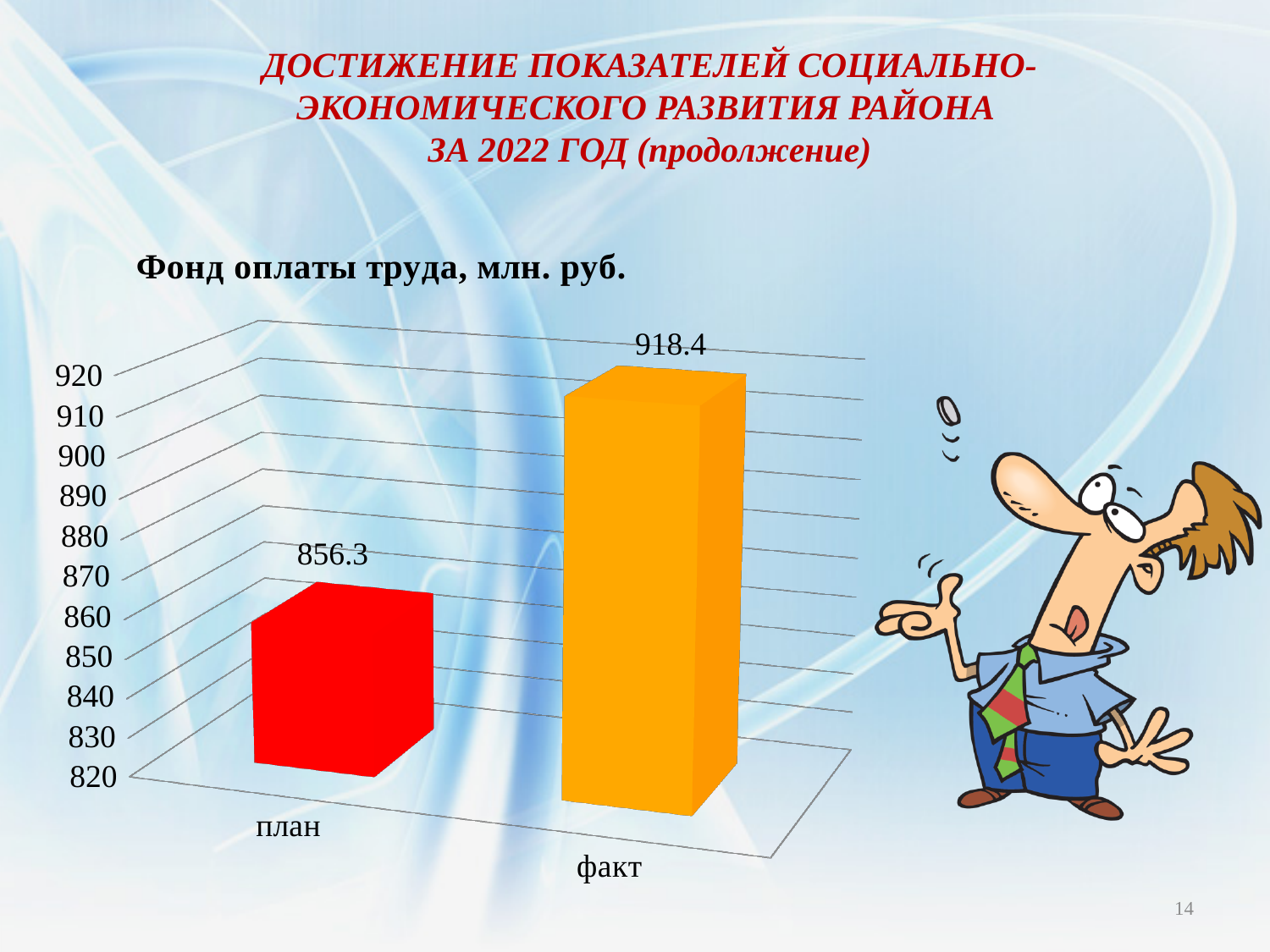
Is the value for факт greater or less than 900? greater Which category has the highest value? факт What is the value for факт? 918.4 How many categories are shown in the chart? 2 What kind of chart is shown on the slide? bar chart What is the title of the chart? Фонд оплаты труда, млн. руб. What colour is the bar for факт? orange What is the value for план? 856.3 Is the value for план greater or less than 900? less Which is larger, the value for план or the value for факт? факт Which category has the lowest value? план What is the difference between the values for факт and план? 62.1